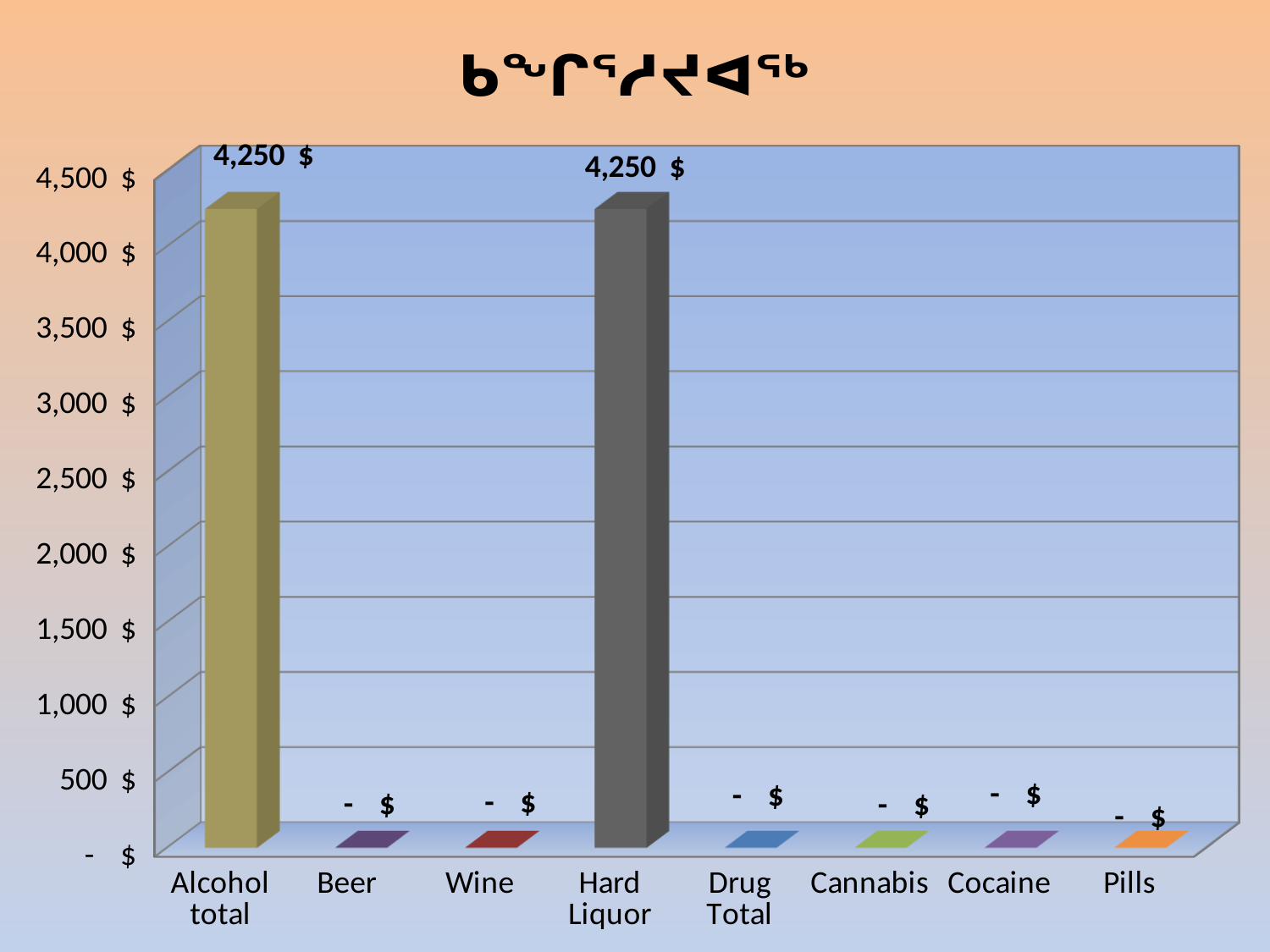
What kind of chart is shown on the slide? Bar chart Which is larger, the value for Hard Liquor or the value for Drug Total? Hard Liquor How many categories are shown on the x axis? 8 Which is larger, the value for Alcohol total or the value for Wine? Alcohol total What is the value for Hard Liquor? 4,250 $ How many categories have a value of 4,250 $? 2 What value is shown for Cannabis? - $ Is the value for Hard Liquor greater or less than 4,000 $? greater What is the value for Alcohol total? 4,250 $ What is the difference between the value for Alcohol total and the value for Hard Liquor? 0 $ What is the highest tick label on the vertical axis? 4,500 $ What value is shown for Beer? - $